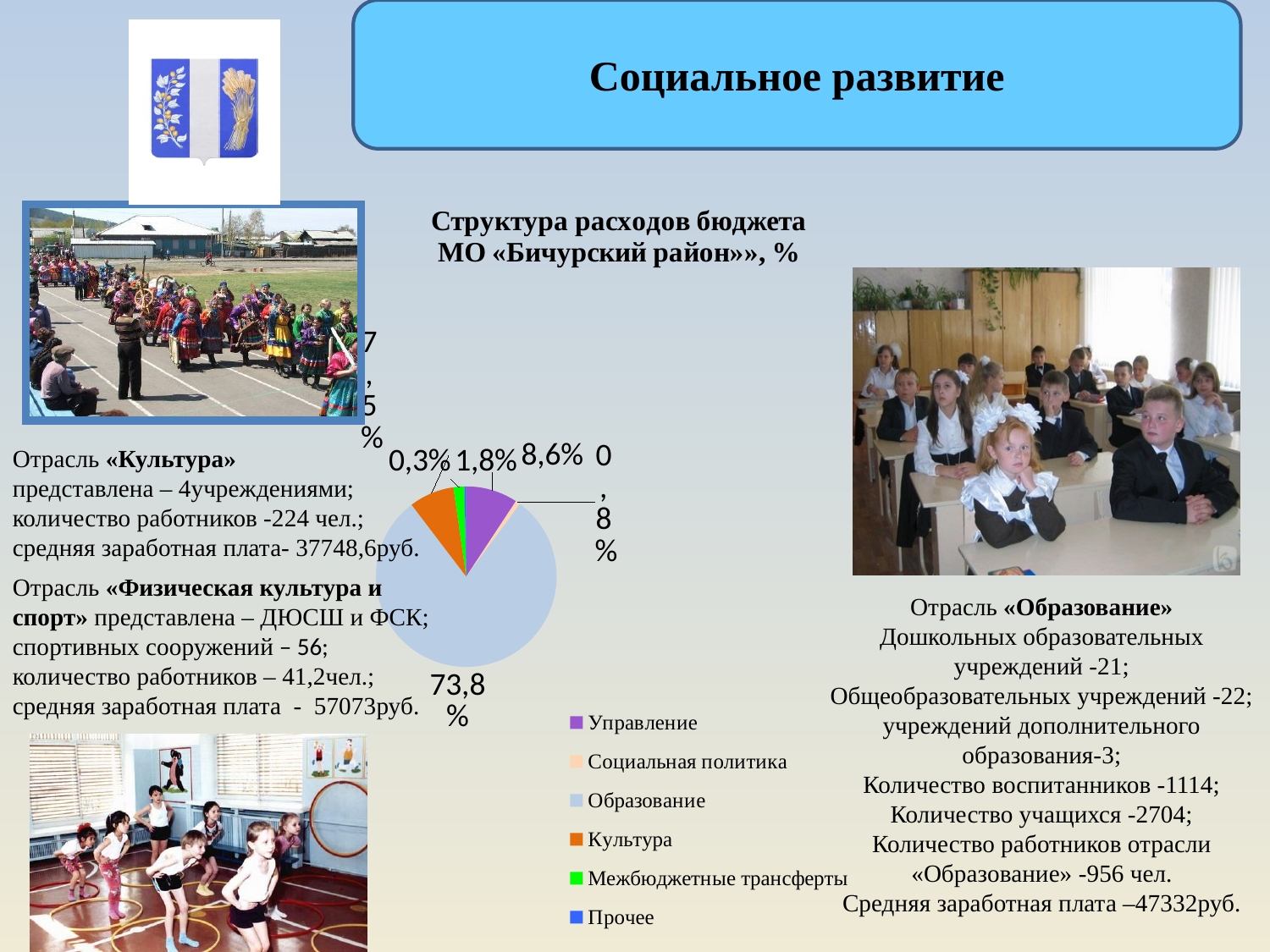
What share of the budget expenditure goes to Образование? 73,8% What is the title of the pie chart? Структура расходов бюджета МО «Бичурский район»», % How many entries does the legend of the pie chart list? 6 What share of the budget expenditure goes to Управление? 8,6% What is the difference between the shares for Управление and Социальная политика? 7,8% Which is larger, the share for Образование or the share for Управление? Образование What share of the budget expenditure goes to Социальная политика? 0,8% What is the difference between the shares for Образование and Управление? 65,2% Which category has the largest slice of the pie chart? Образование What type of chart is shown on the slide? pie chart Which legend entry is shown in orange in the pie chart? Культура Which is larger, the share for Управление or the share for Социальная политика? Управление